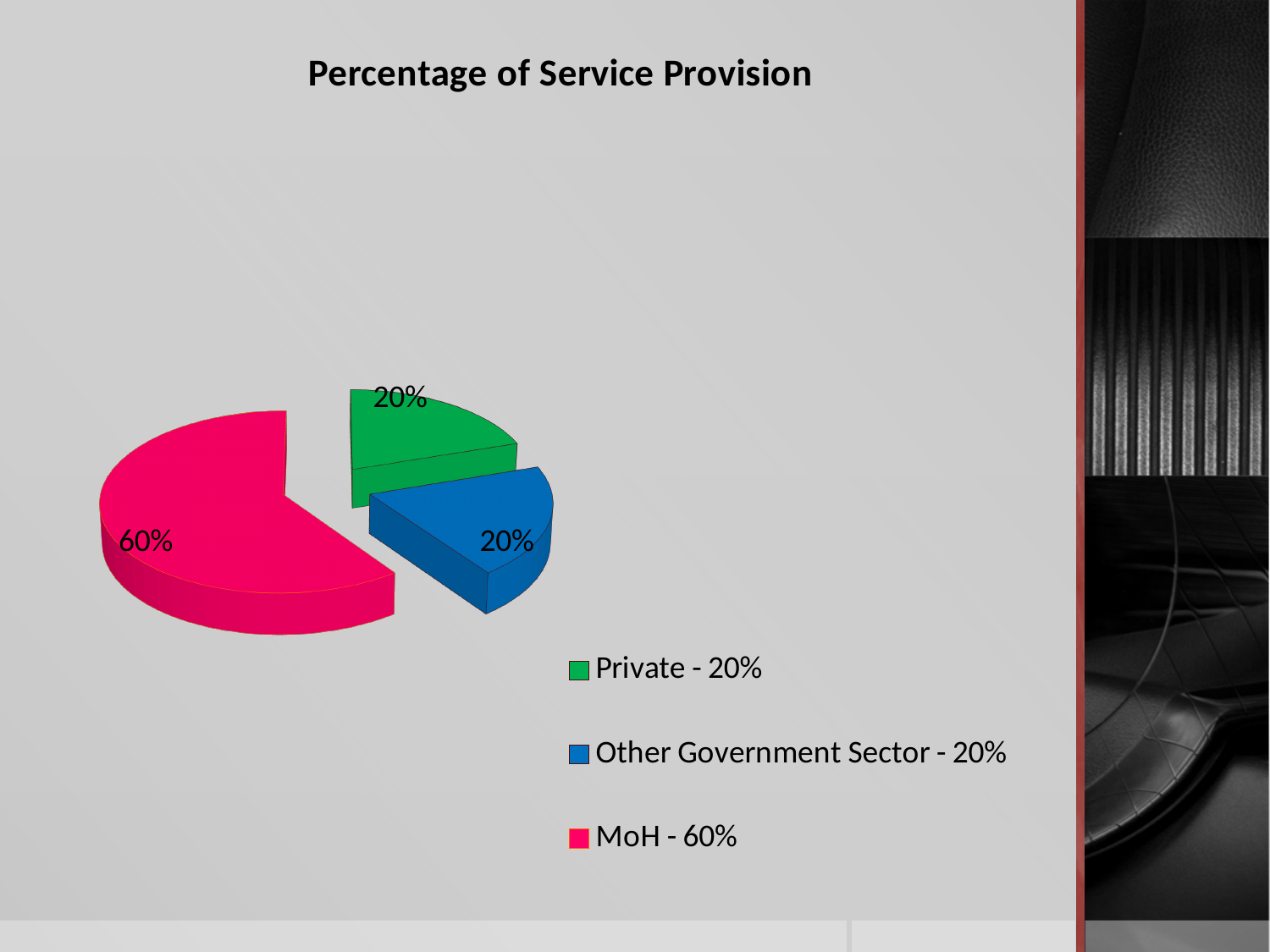
What colour is the MoH slice in the pie chart? Red What percentage of service provision is attributed to Other Government Sector? 20% How many entries does the legend list? 3 What percentage of service provision is attributed to Private? 20% What percentage of service provision is attributed to MoH? 60% What is the title of the chart? Percentage of Service Provision How many slices does the pie chart have? 3 Which category has the largest share of the pie? MoH Is the value for MoH greater or less than 50%? greater What is the difference between the MoH share and the Private share? 40% What type of chart is shown on the slide? Pie chart Which is larger, the share for MoH or the share for Other Government Sector? MoH